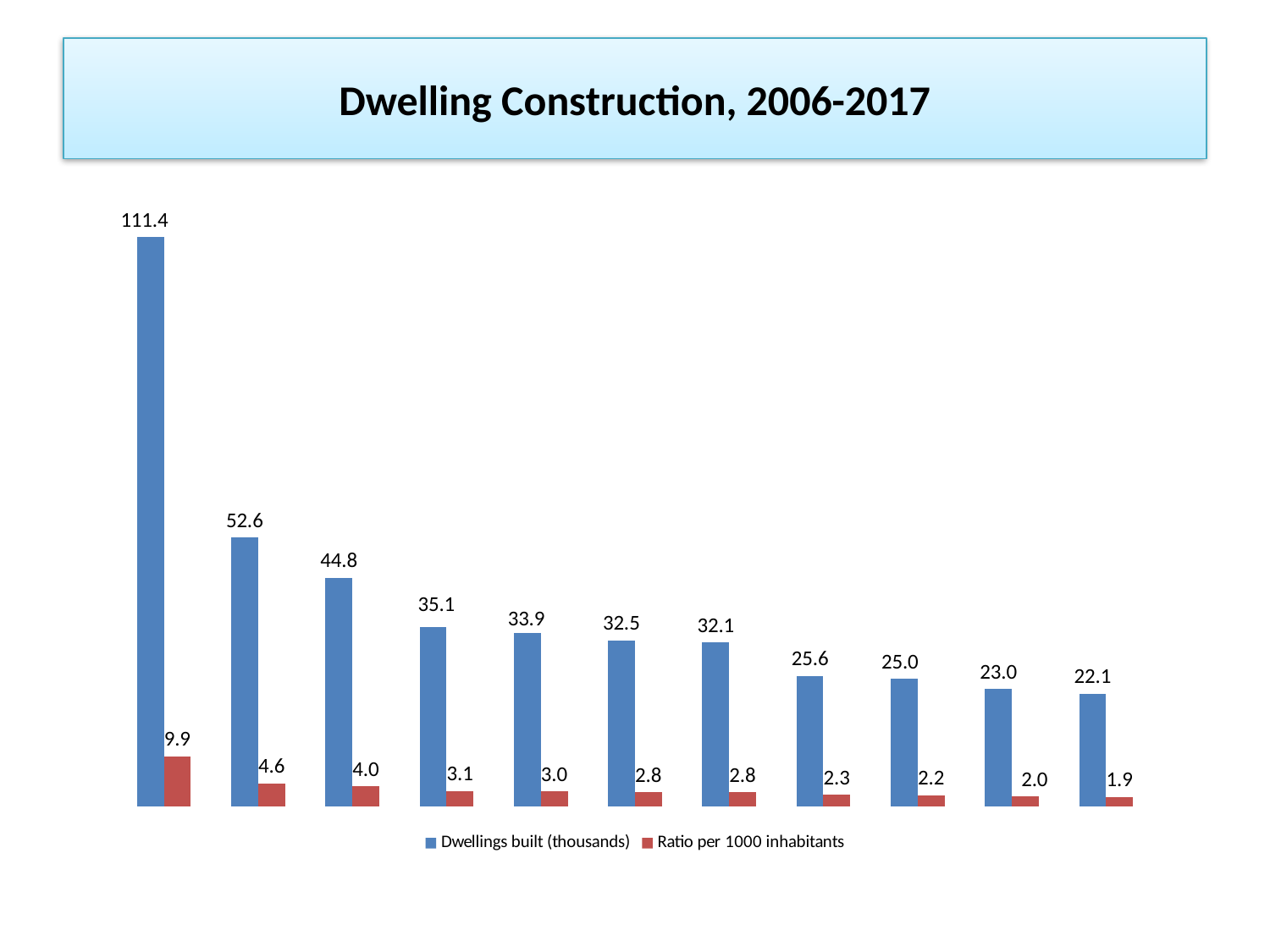
What is the Dwellings built (thousands) value for the second group of bars from the left? 52.6 Do the Dwellings built (thousands) values rise or fall from left to right across the chart? fall How many series does the legend list? 2 What is the highest value shown for Ratio per 1000 inhabitants? 9.9 What is the difference between the highest and second-highest Dwellings built (thousands) values? 58.8 What kind of chart is shown on the slide? bar chart What is the lowest value shown for Ratio per 1000 inhabitants? 1.9 What are the two series named in the legend? Dwellings built (thousands); Ratio per 1000 inhabitants How many groups of bars are plotted in the chart? 11 What is the title of the chart? Dwelling Construction, 2006-2017 What is the highest value shown for Dwellings built (thousands)? 111.4 What is the lowest value shown for Dwellings built (thousands)? 22.1